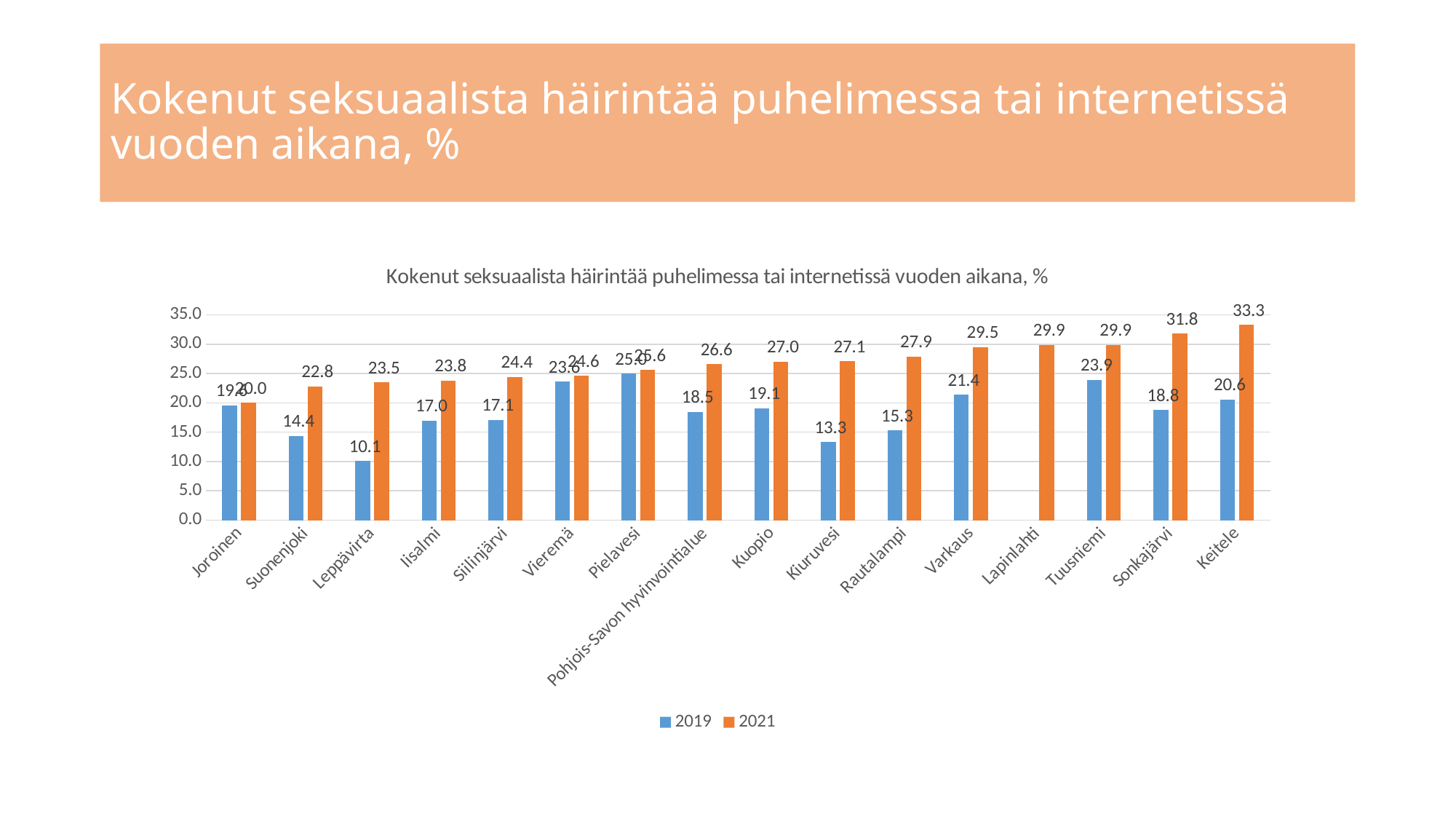
What is the 2021 value for Keitele? 33.3 What is the 2019 value for Leppävirta? 10.1 Is the 2021 value for Varkaus greater or less than 25.0? greater Which category has the lowest 2019 value? Leppävirta How many series does the legend list? 2 What is the 2021 value for Kiuruvesi? 27.1 Which is larger for Rautalampi, the 2019 value or the 2021 value? 2021 What is the difference between the 2021 and 2019 values for Sonkajärvi? 13.0 What kind of chart is shown on the slide? bar chart How many categories are shown on the x axis? 16 Which category has the highest 2021 value? Keitele What is the 2019 value for Tuusniemi? 23.9